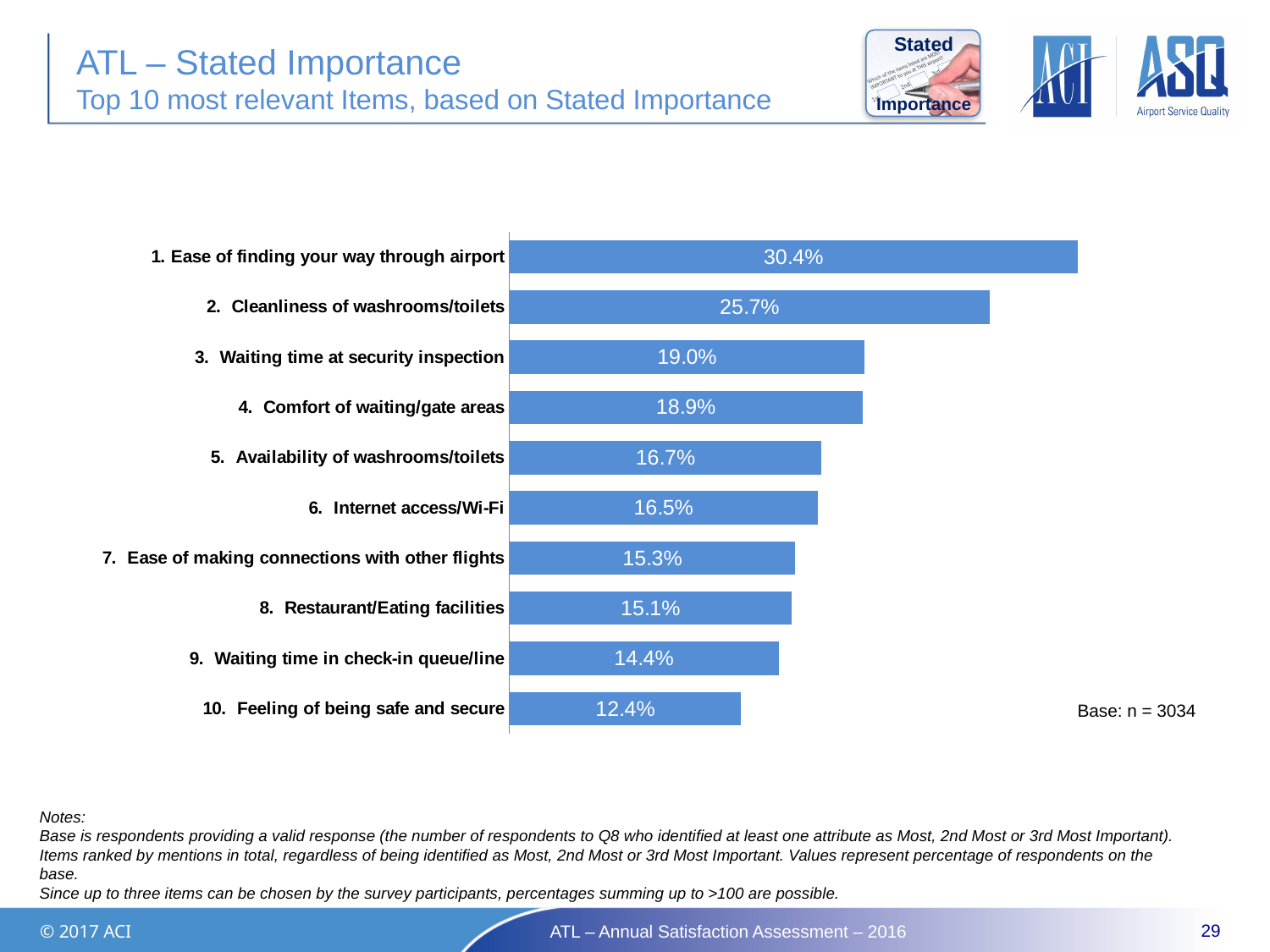
Which is larger: Availability of washrooms/toilets or Restaurant/Eating facilities? Availability of washrooms/toilets What is the value for Internet access/Wi-Fi? 16.5% Which item has the lowest value? Feeling of being safe and secure What kind of chart is shown on the slide? Bar chart What is the difference between Ease of finding your way through airport and Cleanliness of washrooms/toilets? 4.7% What is the base (n) shown next to the chart? n = 3034 What is the value for Ease of finding your way through airport? 30.4% Which item has the highest value? Ease of finding your way through airport What is the value for Waiting time in check-in queue/line? 14.4% Do the values rise or fall going from the top item to the bottom item? Fall What is the difference between Waiting time at security inspection and Feeling of being safe and secure? 6.6% How many items are shown in the chart? 10